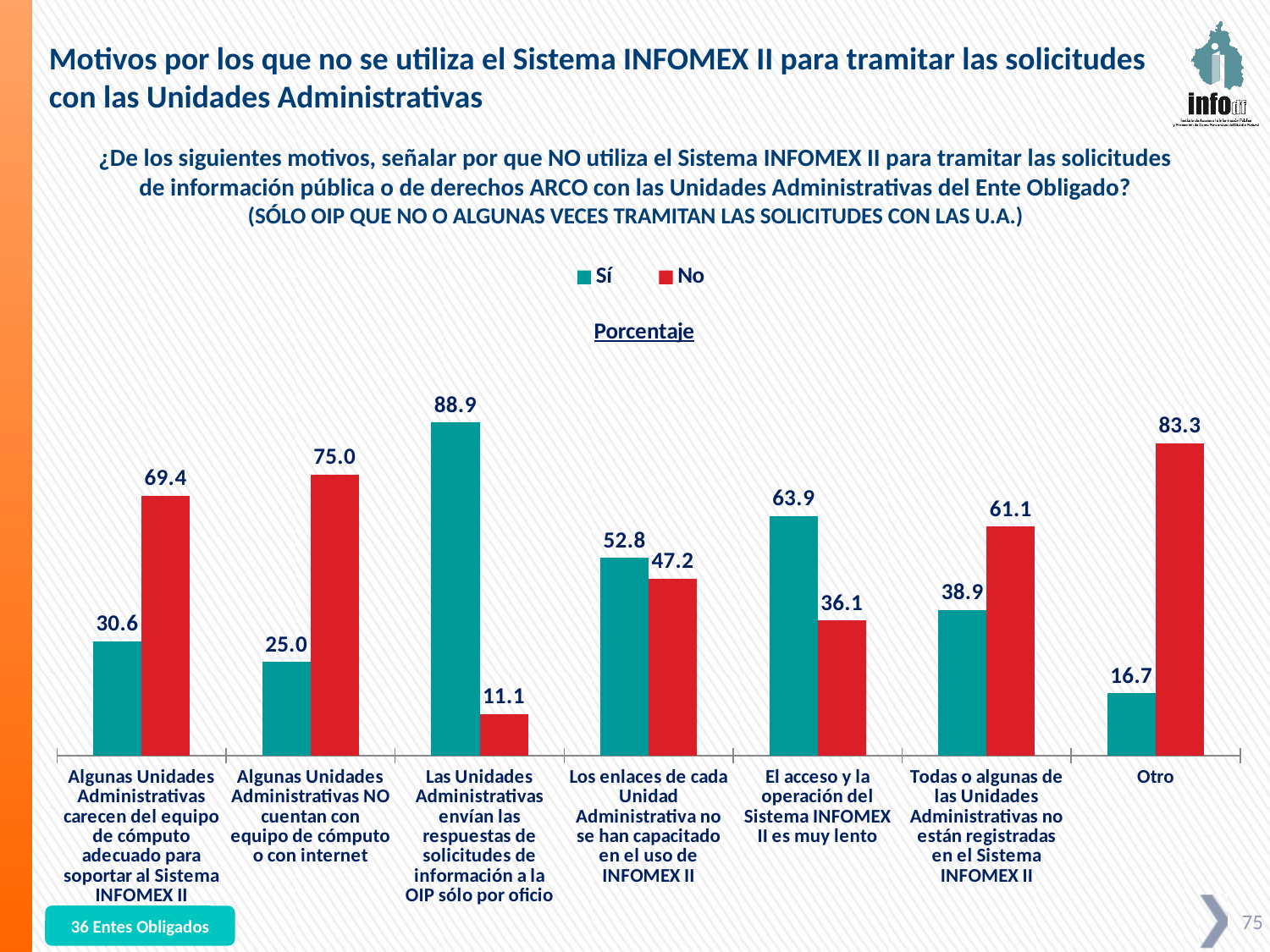
For 'Los enlaces de cada Unidad Administrativa no se han capacitado en el uso de INFOMEX II', which is larger, 'Sí' or 'No'? Sí What is the difference between the 'No' and 'Sí' values for 'Algunas Unidades Administrativas NO cuentan con equipo de cómputo o con internet'? 50.0 What is the 'Sí' value for 'El acceso y la operación del Sistema INFOMEX II es muy lento'? 63.9 What is the 'Sí' value for 'Las Unidades Administrativas envían las respuestas de solicitudes de información a la OIP sólo por oficio'? 88.9 Which category has the lowest 'No' value? Las Unidades Administrativas envían las respuestas de solicitudes de información a la OIP sólo por oficio Which category has the highest 'Sí' value? Las Unidades Administrativas envían las respuestas de solicitudes de información a la OIP sólo por oficio What is the 'No' value for 'Otro'? 83.3 What is the 'No' value for 'Todas o algunas de las Unidades Administrativas no están registradas en el Sistema INFOMEX II'? 61.1 How many series does the legend list? 2 What kind of chart is shown on the slide? Bar chart How many categories are shown on the x axis? 7 Which colour represents the 'No' series in the legend? Red